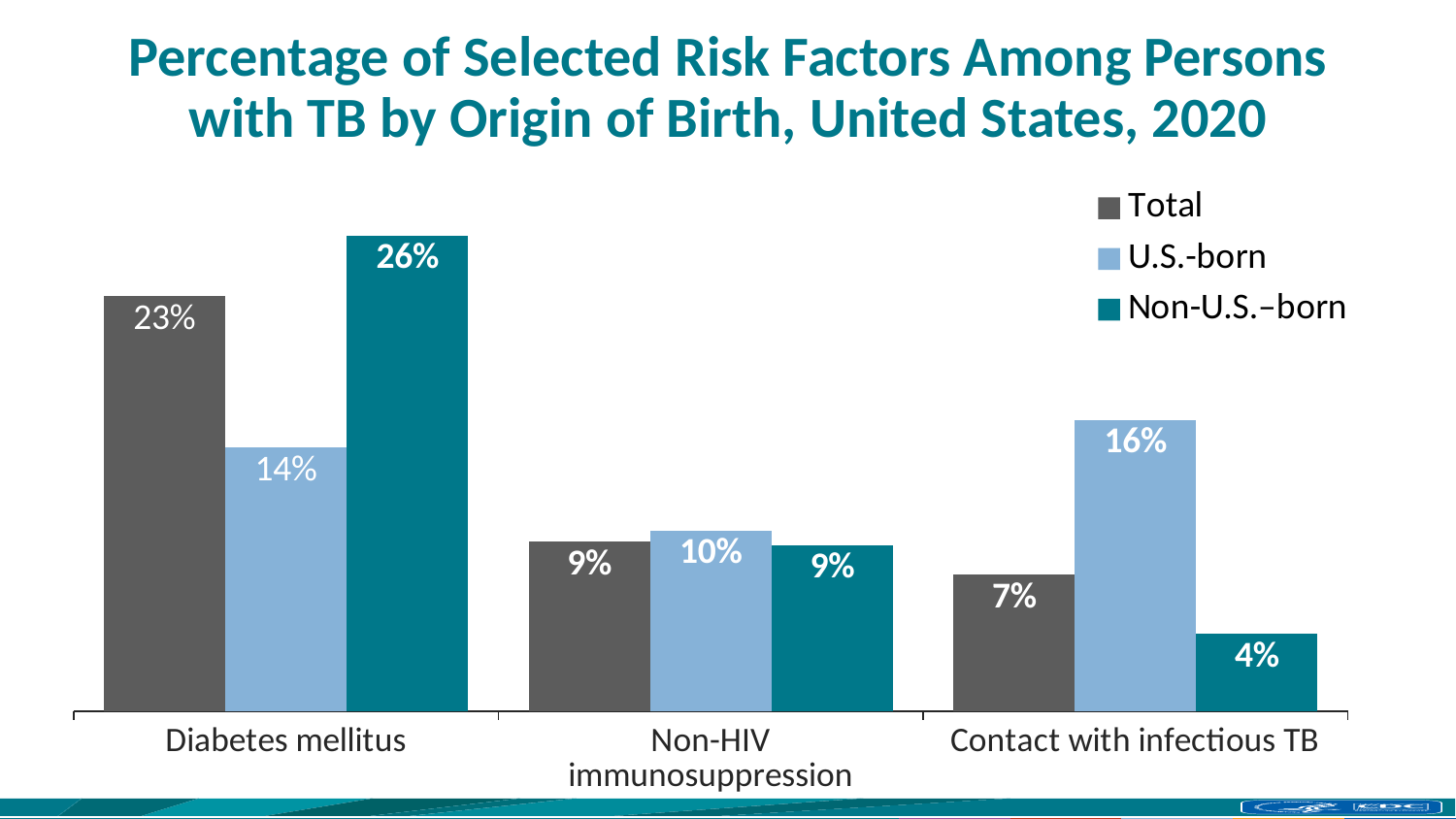
What is the Non-U.S.-born value for Diabetes mellitus? 26% Do the Total values rise or fall from Diabetes mellitus to Contact with infectious TB? Fall What is the difference between the Non-U.S.-born and U.S.-born values for Diabetes mellitus? 12% Which category has the highest Total value? Diabetes mellitus What is the Total value for Non-HIV immunosuppression? 9% Which category has the lowest Non-U.S.-born value? Contact with infectious TB What kind of chart is shown on the slide? Bar chart What is the U.S.-born value for Contact with infectious TB? 16% How many series does the legend list? 3 How many risk factor categories are shown on the x axis? 3 What is the title of the chart? Percentage of Selected Risk Factors Among Persons with TB by Origin of Birth, United States, 2020 For Contact with infectious TB, which is larger: the U.S.-born value or the Non-U.S.-born value? U.S.-born